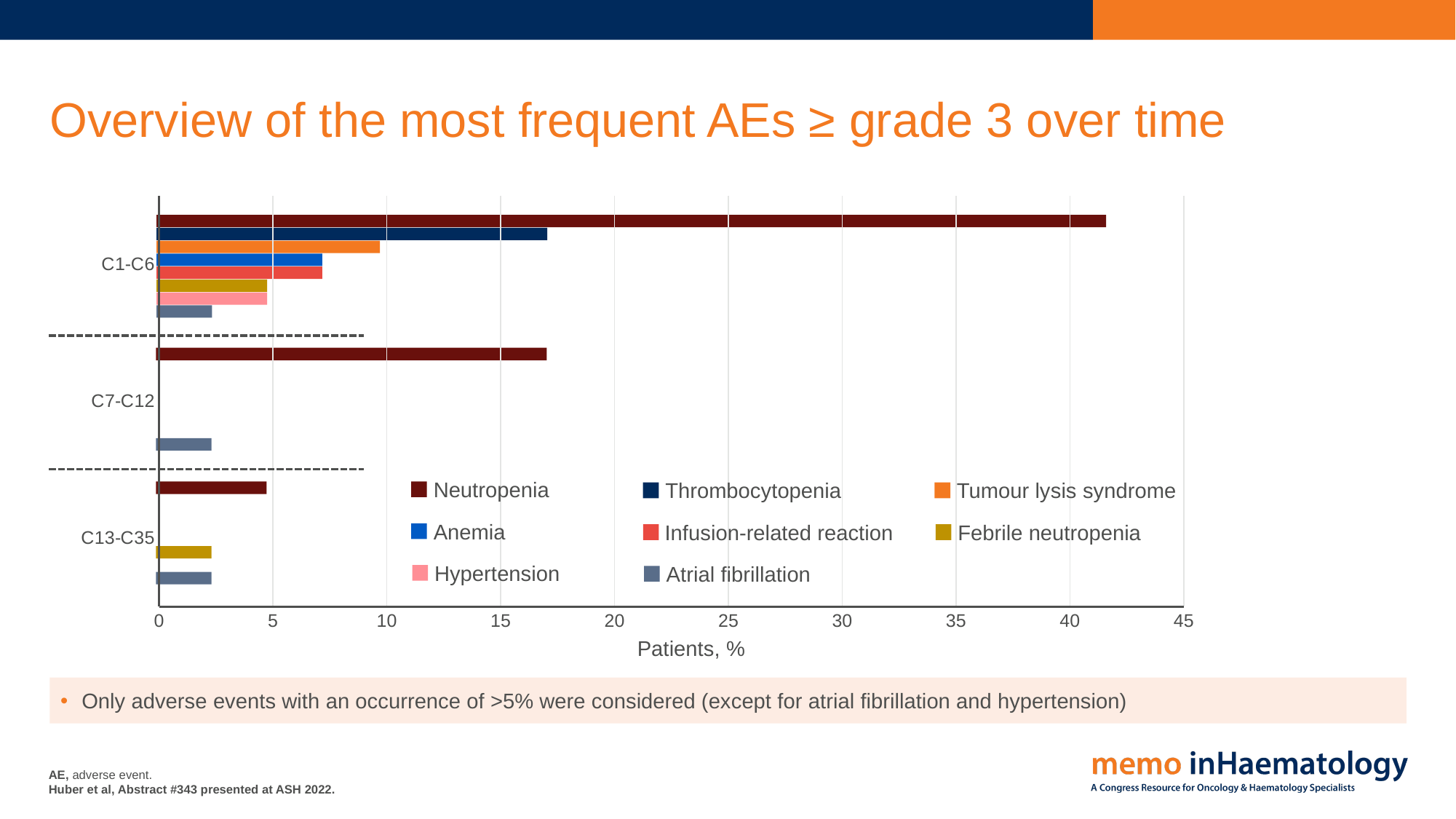
How many cycle groups (categories) are shown on the y axis? 3 Which adverse event has the highest value in the C1-C6 group? Neutropenia How many series does the legend list? 8 Which is larger in C1-C6: Thrombocytopenia or Anemia? Thrombocytopenia Does the value for Neutropenia rise or fall from C1-C6 to C13-C35? Fall Which adverse event has the lowest value in the C1-C6 group? Atrial fibrillation What kind of chart is shown on the slide? Bar chart Is the value for Neutropenia in C7-C12 greater or less than 15? greater Is the value for Neutropenia in C1-C6 greater or less than 40? greater Is the value for Thrombocytopenia in C1-C6 greater or less than 15? greater